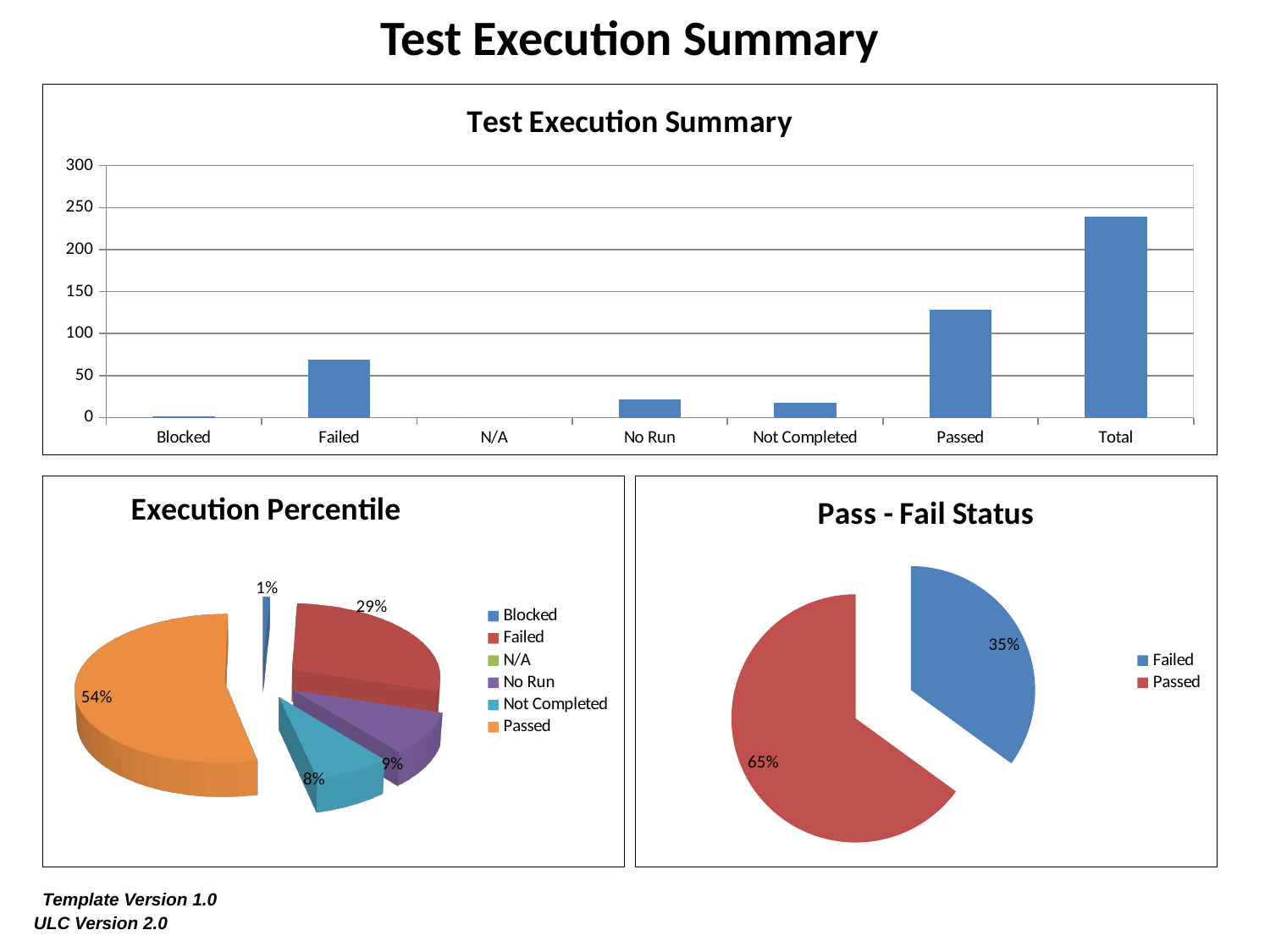
In the Pass - Fail Status pie chart, what share does Failed have? 35% In the Test Execution Summary bar chart, which category has the highest value? Total In the Test Execution Summary bar chart, which is larger, No Run or Not Completed? No Run In the Execution Percentile pie chart, what share does Passed have? 54% In the Execution Percentile pie chart, what share does Failed have? 29% In the Test Execution Summary bar chart, is the value for Failed greater or less than 100? less In the Test Execution Summary bar chart, is the value for Total greater or less than 200? greater What kind of chart is the Test Execution Summary chart at the top of the slide? bar chart How many entries does the legend of the Execution Percentile pie chart list? 6 How many categories are shown on the x axis of the Test Execution Summary bar chart? 7 In the Execution Percentile pie chart, what is the difference between the No Run share and the Not Completed share? 1% In the Test Execution Summary bar chart, is the value for Passed greater or less than 100? greater